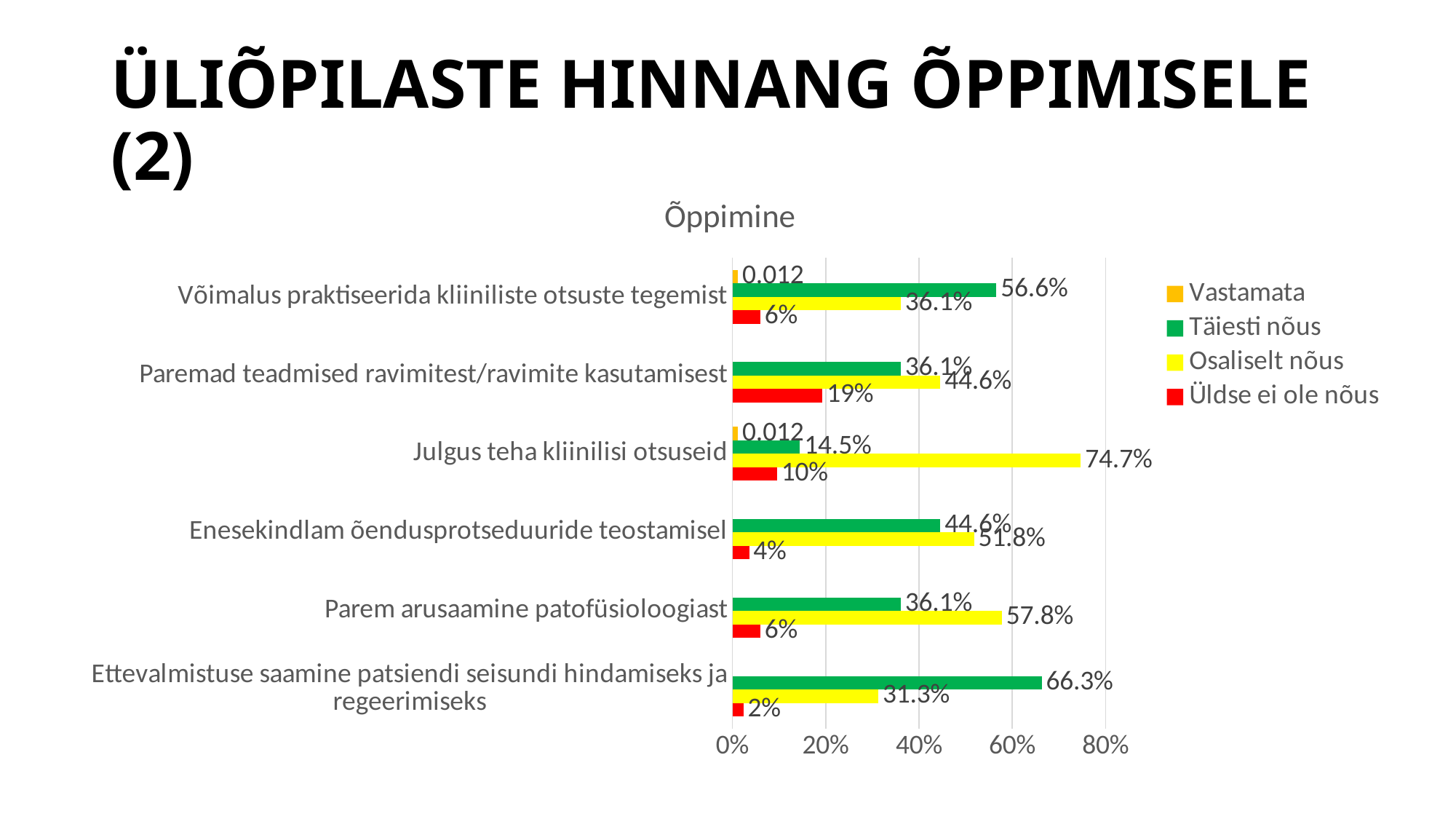
What is the Täiesti nõus value for "Ettevalmistuse saamine patsiendi seisundi hindamiseks ja regeerimiseks"? 66.3% Which category has the lowest Üldse ei ole nõus value? Ettevalmistuse saamine patsiendi seisundi hindamiseks ja regeerimiseks What is the Osaliselt nõus value for "Julgus teha kliinilisi otsuseid"? 74.7% What kind of chart is shown on the slide? Bar chart What is the difference between the Osaliselt nõus and Täiesti nõus values for "Parem arusaamine patofüsioloogiast"? 21.7% How many series does the legend list? 4 What is the Täiesti nõus value for "Võimalus praktiseerida kliiniliste otsuste tegemist"? 56.6% How many categories are shown on the chart? 6 What is the title of the chart? Õppimine For "Enesekindlam õendusprotseduuride teostamisel", which is larger: Täiesti nõus or Osaliselt nõus? Osaliselt nõus What is the Üldse ei ole nõus value for "Paremad teadmised ravimitest/ravimite kasutamisest"? 19% Which category has the highest Täiesti nõus value? Ettevalmistuse saamine patsiendi seisundi hindamiseks ja regeerimiseks